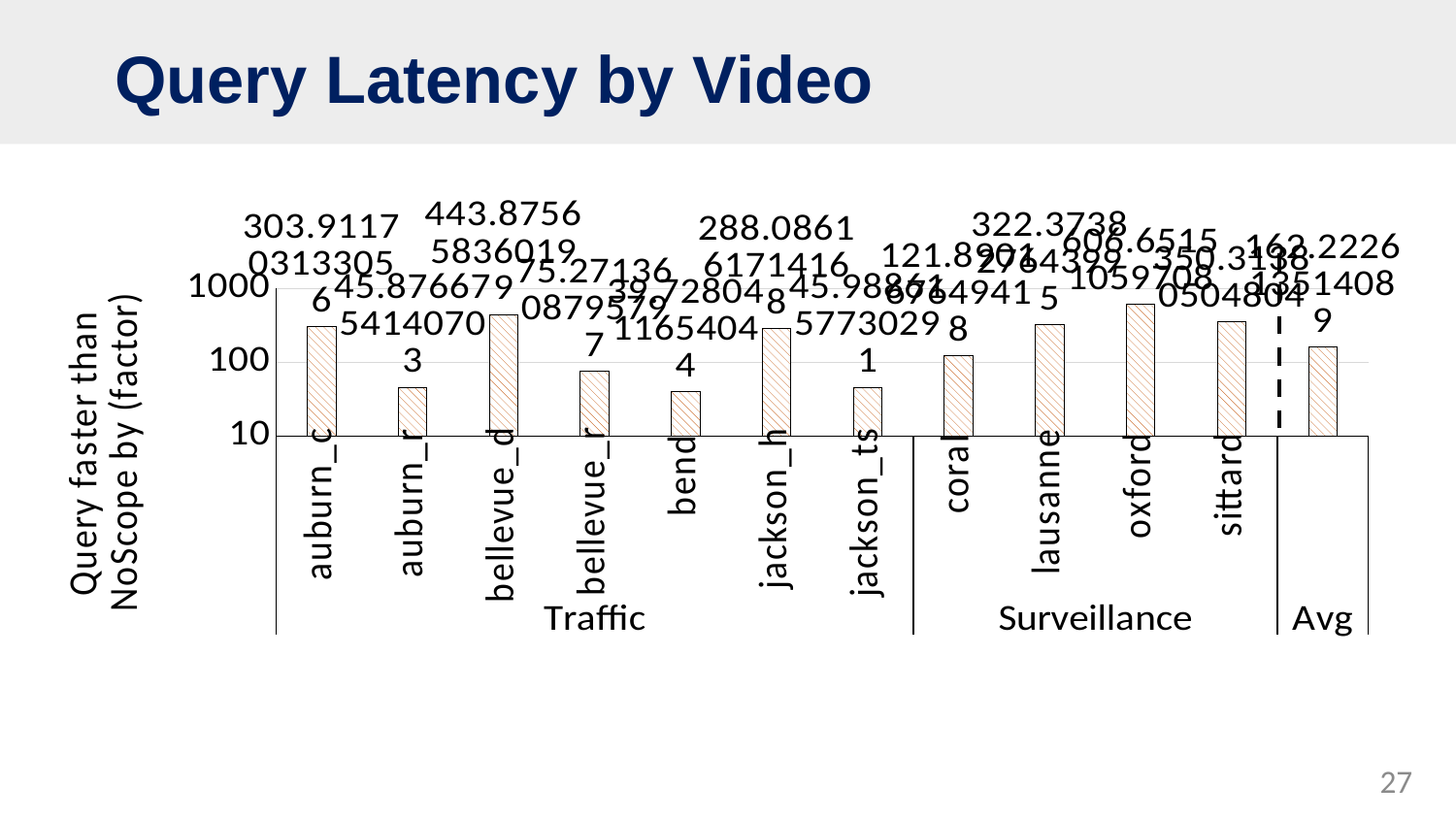
How many videos are grouped under the Surveillance category? 4 Is the value for bend greater or less than 100? less How many videos are grouped under the Traffic category? 7 How many bars are plotted in the chart? 12 Is the value for Avg greater or less than 100? greater What is the label on the y axis of the chart? Query faster than NoScope by (factor) Is the value for auburn_r greater or less than 100? less Which video has the highest bar in the chart? oxford What kind of chart is shown on the slide? bar chart Which has the larger value, auburn_c or auburn_r? auburn_c Which has the larger value, lausanne or coral? lausanne